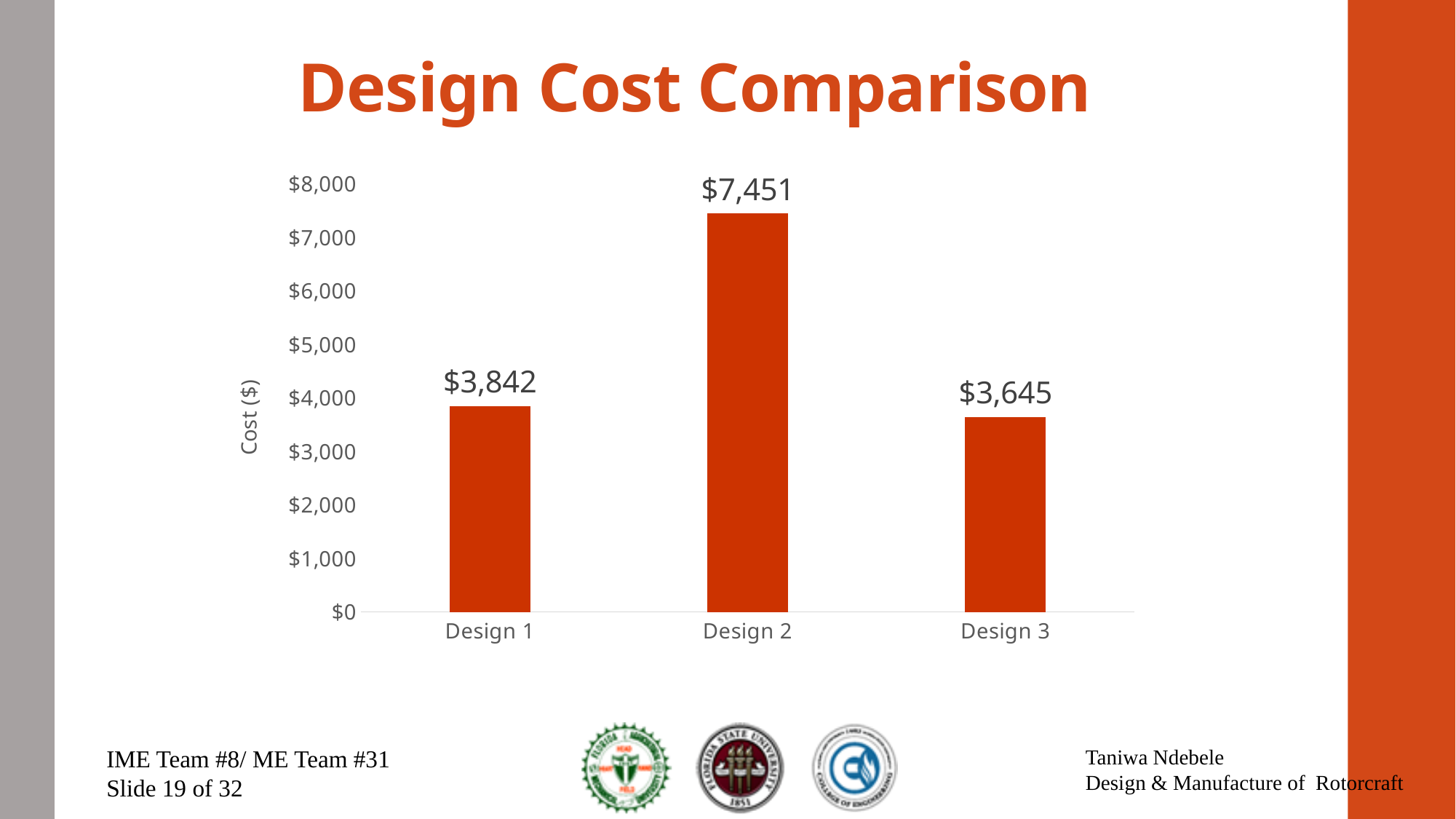
What is the difference in cost between Design 1 and Design 3? $197 What is the cost for Design 3? $3,645 Which design has the lowest cost? Design 3 How many designs are compared in the chart? 3 What is the cost for Design 1? $3,842 What is the cost for Design 2? $7,451 Is the cost for Design 2 greater or less than $7,000? greater What is the label of the vertical axis? Cost ($) What kind of chart is shown on the slide? Bar chart What is the difference in cost between Design 2 and Design 1? $3,609 Which costs more, Design 1 or Design 3? Design 1 Which design has the highest cost? Design 2